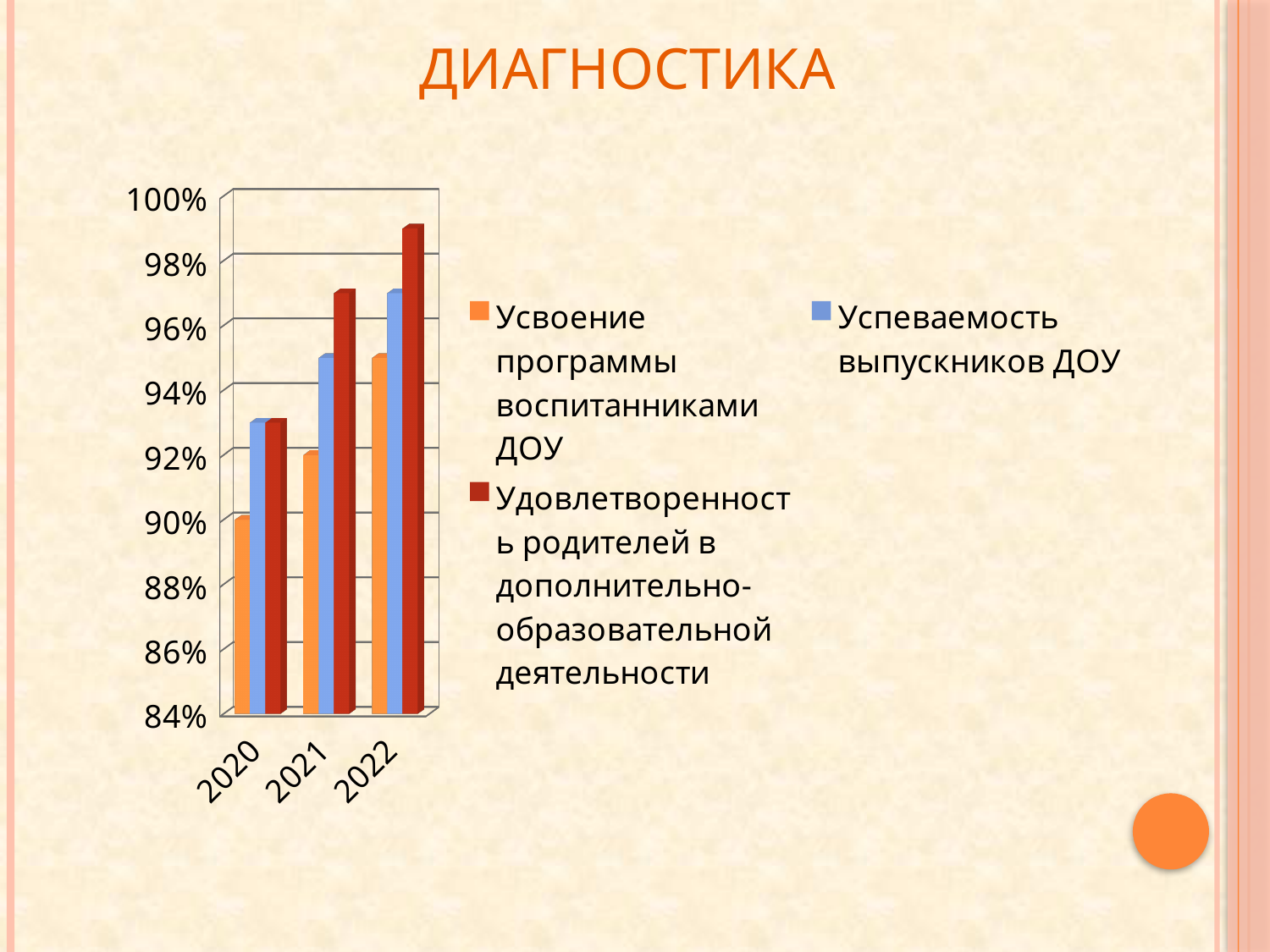
Which series is shown in orange in the chart's legend? Усвоение программы воспитанниками ДОУ How many series does the chart's legend list? 3 Is the value for Усвоение программы воспитанниками ДОУ in 2020 greater or less than 92%? less Is the value for Успеваемость выпускников ДОУ in 2022 greater or less than 96%? greater What is the title of the slide containing the chart? ДИАГНОСТИКА How many years (categories) are shown on the x axis of the chart? 3 Do the values for Усвоение программы воспитанниками ДОУ rise or fall from 2020 to 2022? rise In which year is the value for Удовлетворенность родителей в дополнительно-образовательной деятельности highest? 2022 Is the value for Успеваемость выпускников ДОУ in 2020 greater or less than 94%? less In which year is the value for Усвоение программы воспитанниками ДОУ lowest? 2020 What kind of chart is shown on the slide? bar chart